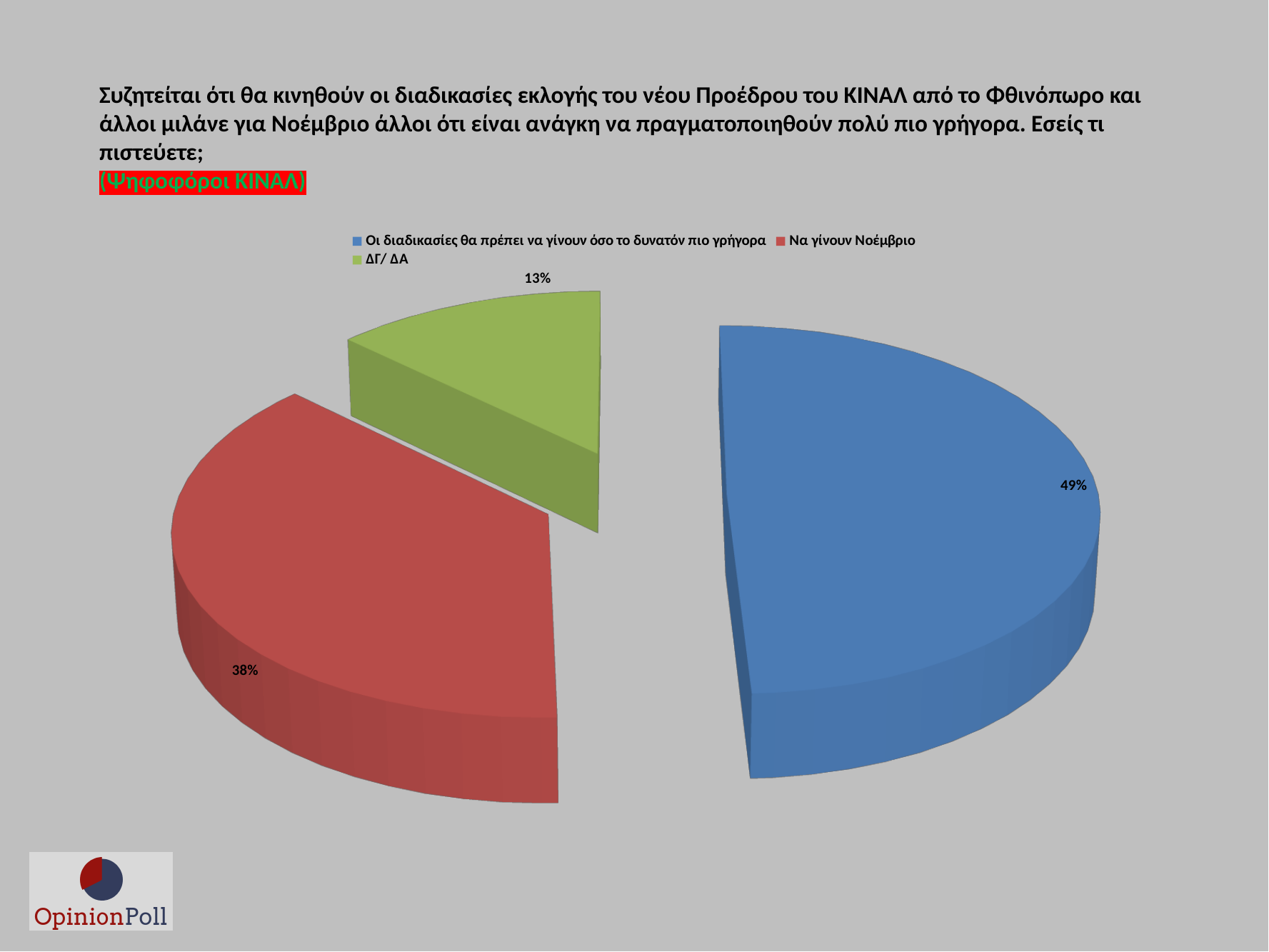
What is the difference in percentage points between "Οι διαδικασίες θα πρέπει να γίνουν όσο το δυνατόν πιο γρήγορα" and "Να γίνουν Νοέμβριο"? 11 percentage points Which response has the largest share of the pie? Οι διαδικασίες θα πρέπει να γίνουν όσο το δυνατόν πιο γρήγορα Which response has the smallest share of the pie? ΔΓ/ ΔΑ What percentage of respondents answered "ΔΓ/ ΔΑ"? 13% What is the difference in percentage points between "Να γίνουν Νοέμβριο" and "ΔΓ/ ΔΑ"? 25 percentage points How many entries does the legend list? 3 What kind of chart is shown on the slide? pie chart What colour is the slice for "Να γίνουν Νοέμβριο"? red What percentage of respondents chose "Να γίνουν Νοέμβριο"? 38% Which is larger: the share for "Να γίνουν Νοέμβριο" or the share for "ΔΓ/ ΔΑ"? Να γίνουν Νοέμβριο How many slices does the pie chart have? 3 What percentage of respondents chose "Οι διαδικασίες θα πρέπει να γίνουν όσο το δυνατόν πιο γρήγορα"? 49%